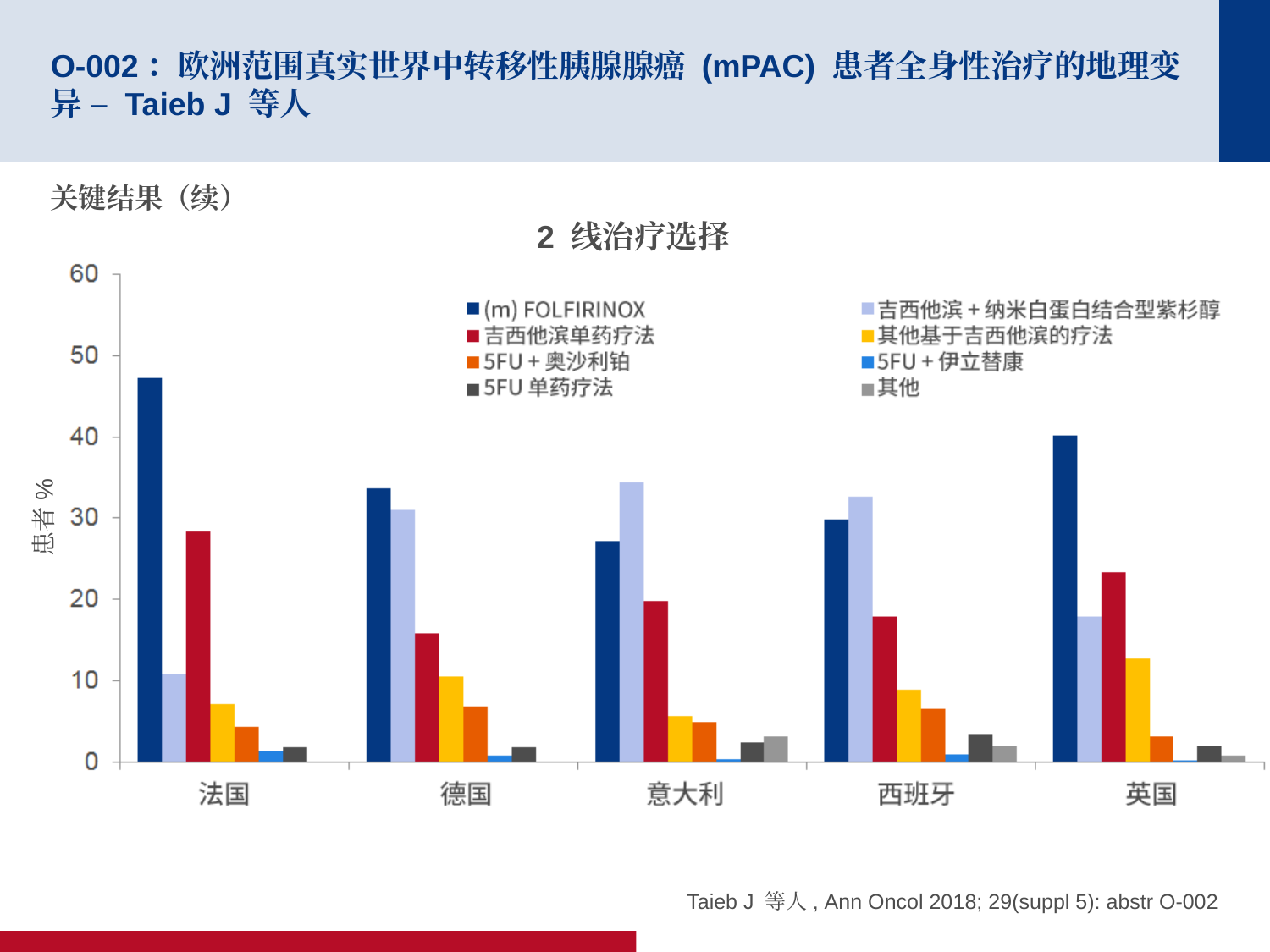
Which country has the highest value for (m) FOLFIRINOX? 法国 What kind of chart is shown on the slide? bar chart In 意大利, which is larger: (m) FOLFIRINOX or 吉西他滨 + 纳米白蛋白结合型紫杉醇? 吉西他滨 + 纳米白蛋白结合型紫杉醇 Which country has the lowest value for 吉西他滨 + 纳米白蛋白结合型紫杉醇? 法国 Is the value for 吉西他滨 + 纳米白蛋白结合型紫杉醇 in 意大利 greater or less than 30? greater What is the title of the chart? 2 线治疗选择 How many series does the chart's legend list? 8 How many countries are shown on the x axis of the chart? 5 Which country has the highest value for 吉西他滨单药疗法? 法国 Is the value for (m) FOLFIRINOX in 英国 greater or less than 30? greater In 英国, which is larger: 吉西他滨单药疗法 or 吉西他滨 + 纳米白蛋白结合型紫杉醇? 吉西他滨单药疗法 Is the value for (m) FOLFIRINOX in 法国 greater or less than 40? greater